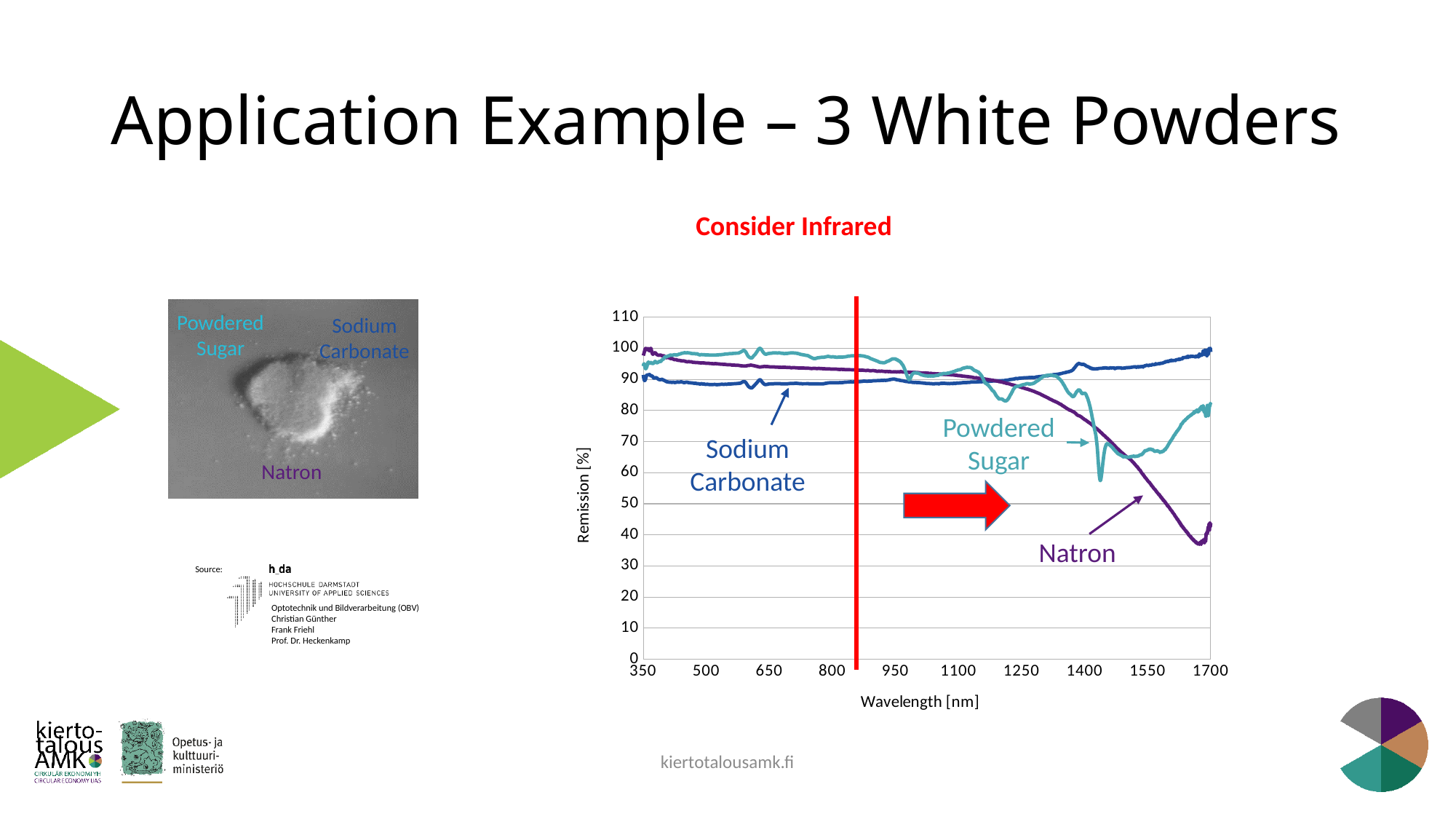
Is the lowest value reached by the Powdered Sugar curve greater or less than 70? less Is the remission of Natron at 1700 nm greater or less than 50? less Is the remission of Sodium Carbonate at 1700 nm greater or less than 90? greater What kind of chart is shown on the slide? line chart Does the Natron curve rise or fall as wavelength increases from 350 nm to 1700 nm? fall What is the label of the x axis of the chart? Wavelength [nm] What is the label of the y axis of the chart? Remission [%] At 1700 nm, which has the higher remission, Sodium Carbonate or Natron? Sodium Carbonate Does the Sodium Carbonate curve rise or fall between 1250 nm and 1700 nm? rise At 350 nm, which has the higher remission, Natron or Sodium Carbonate? Natron How many series (powders) are plotted on the chart? 3 Which series has the lowest remission at 1700 nm? Natron